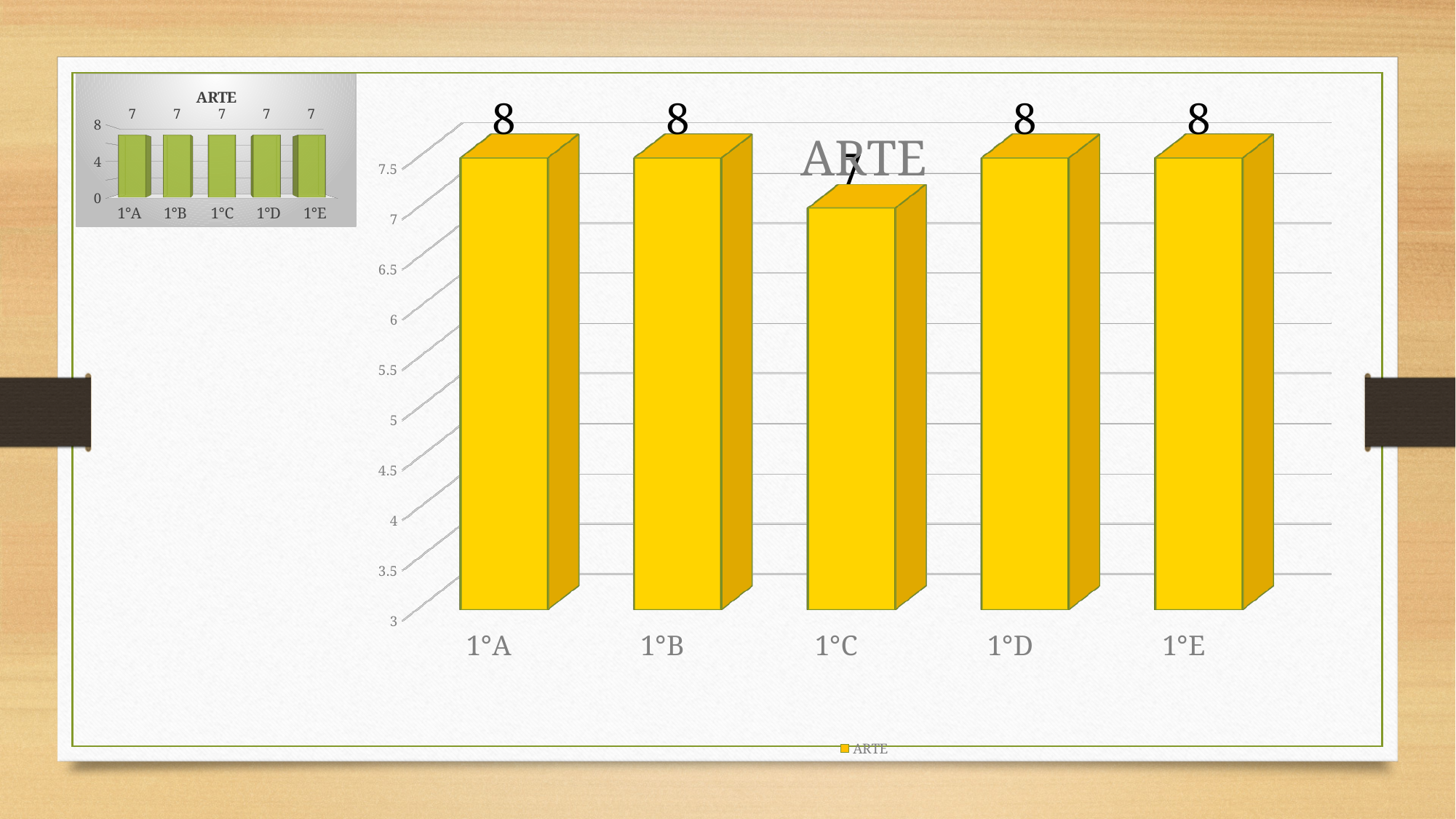
In the small chart in the top-left corner, how many bars are there? 5 In the large chart, which is larger, the value for 1°B or the value for 1°C? 1°B In the large chart, which category has the lowest value? 1°C In the large chart, what is the value for 1°A? 8 In the large chart, how many categories are shown on the x axis? 5 In the large chart, what is the value for 1°C? 7 In the small chart in the top-left corner, what is the value for 1°E? 7 In the large chart, how many series does the legend list? 1 In the large chart, what is the difference between the values for 1°D and 1°C? 1 What is the title of the large chart? ARTE In the large chart, what is the total of the values for 1°A and 1°C? 15 What kind of chart is the large chart? bar chart